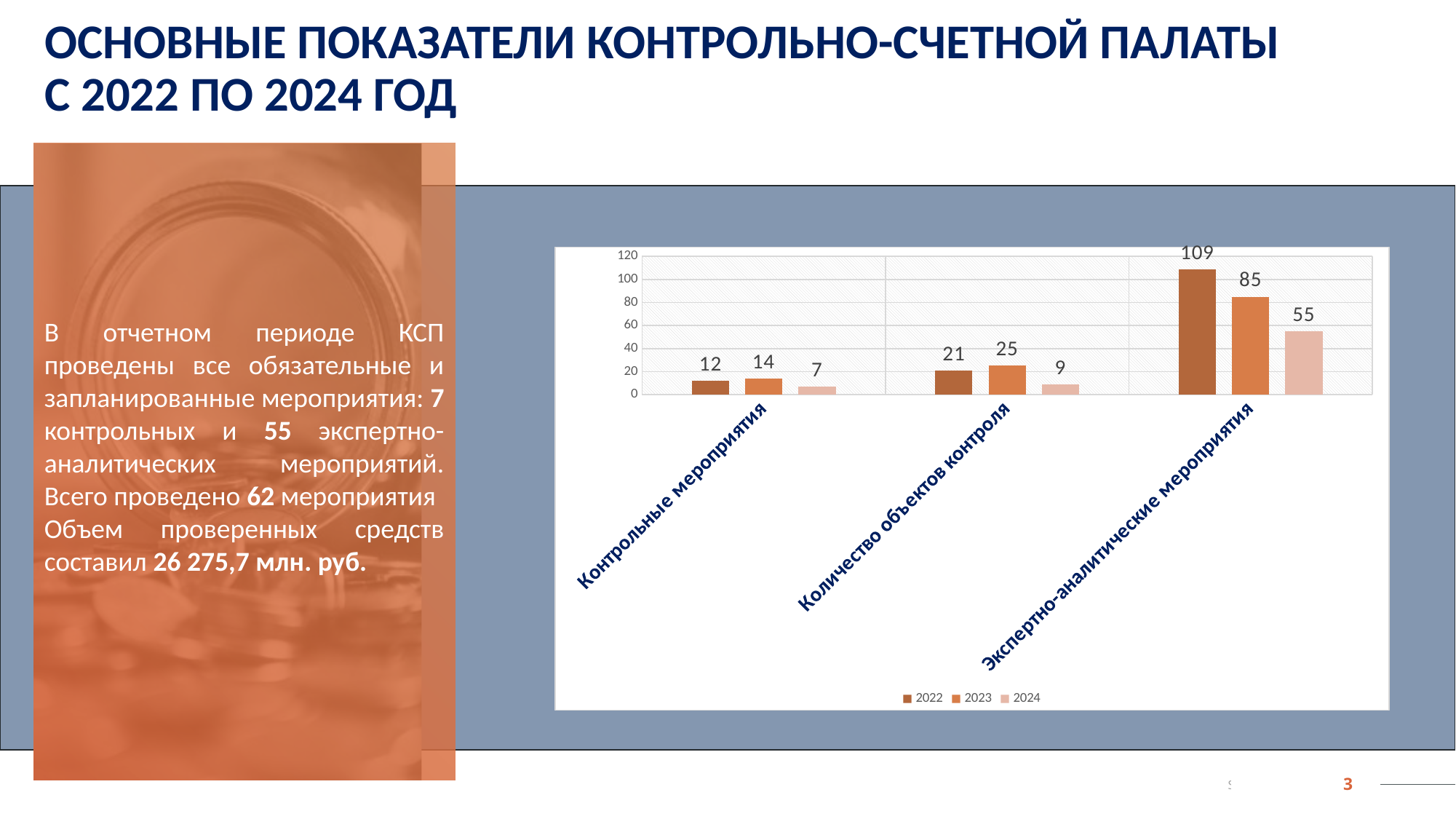
Which years are listed in the chart legend? 2022, 2023, 2024 What is the value for 2023 in the category "Экспертно-аналитические мероприятия"? 85 Which is larger in the category "Количество объектов контроля": the 2022 value or the 2023 value? 2023 How many categories are shown on the x axis of the chart? 3 What is the difference between the 2022 and 2024 values for "Экспертно-аналитические мероприятия"? 54 Which category has the lowest value for the 2024 series? Контрольные мероприятия What is the value for 2024 in the category "Количество объектов контроля"? 9 Which category has the highest value for the 2022 series? Экспертно-аналитические мероприятия Is the 2022 value for "Экспертно-аналитические мероприятия" greater or less than 100? greater What kind of chart is shown on the slide? bar chart How many series does the chart legend list? 3 What is the value for 2022 in the category "Контрольные мероприятия"? 12